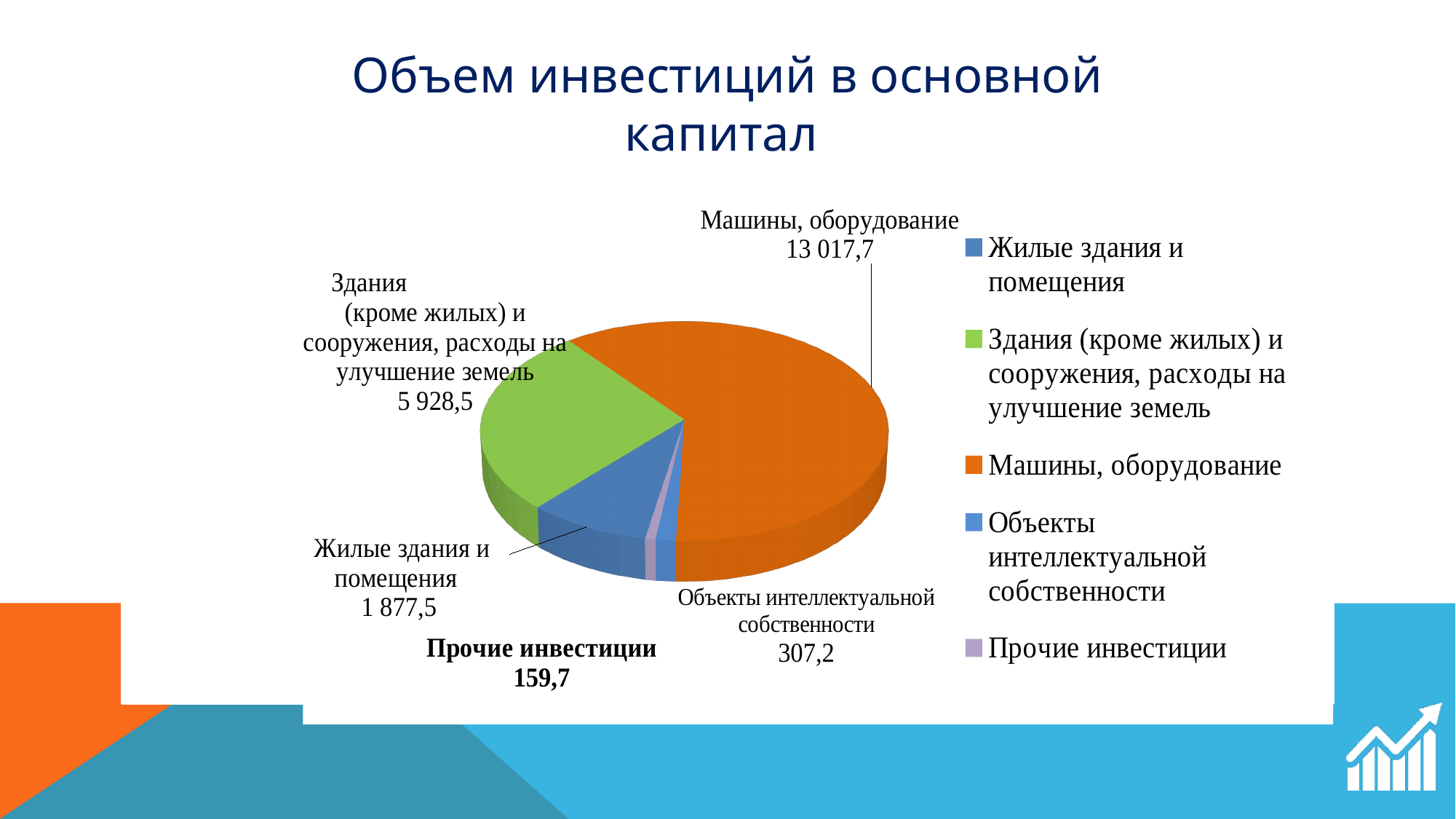
What is the value for Прочие инвестиции? 159,7 What is the value for Машины, оборудование? 13 017,7 What is the value for Жилые здания и помещения? 1 877,5 What kind of chart is shown on the slide? Pie chart Which category has the largest slice of the pie? Машины, оборудование What is the difference between the values for Машины, оборудование and Здания (кроме жилых) и сооружения, расходы на улучшение земель? 7 089,2 Which is larger: the value for Жилые здания и помещения or the value for Объекты интеллектуальной собственности? Жилые здания и помещения How many categories does the pie chart have? 5 Which category has the smallest slice of the pie? Прочие инвестиции What is the title of the slide? Объем инвестиций в основной капитал What is the value for Здания (кроме жилых) и сооружения, расходы на улучшение земель? 5 928,5 What is the total of all the values shown in the pie chart? 21 290,6